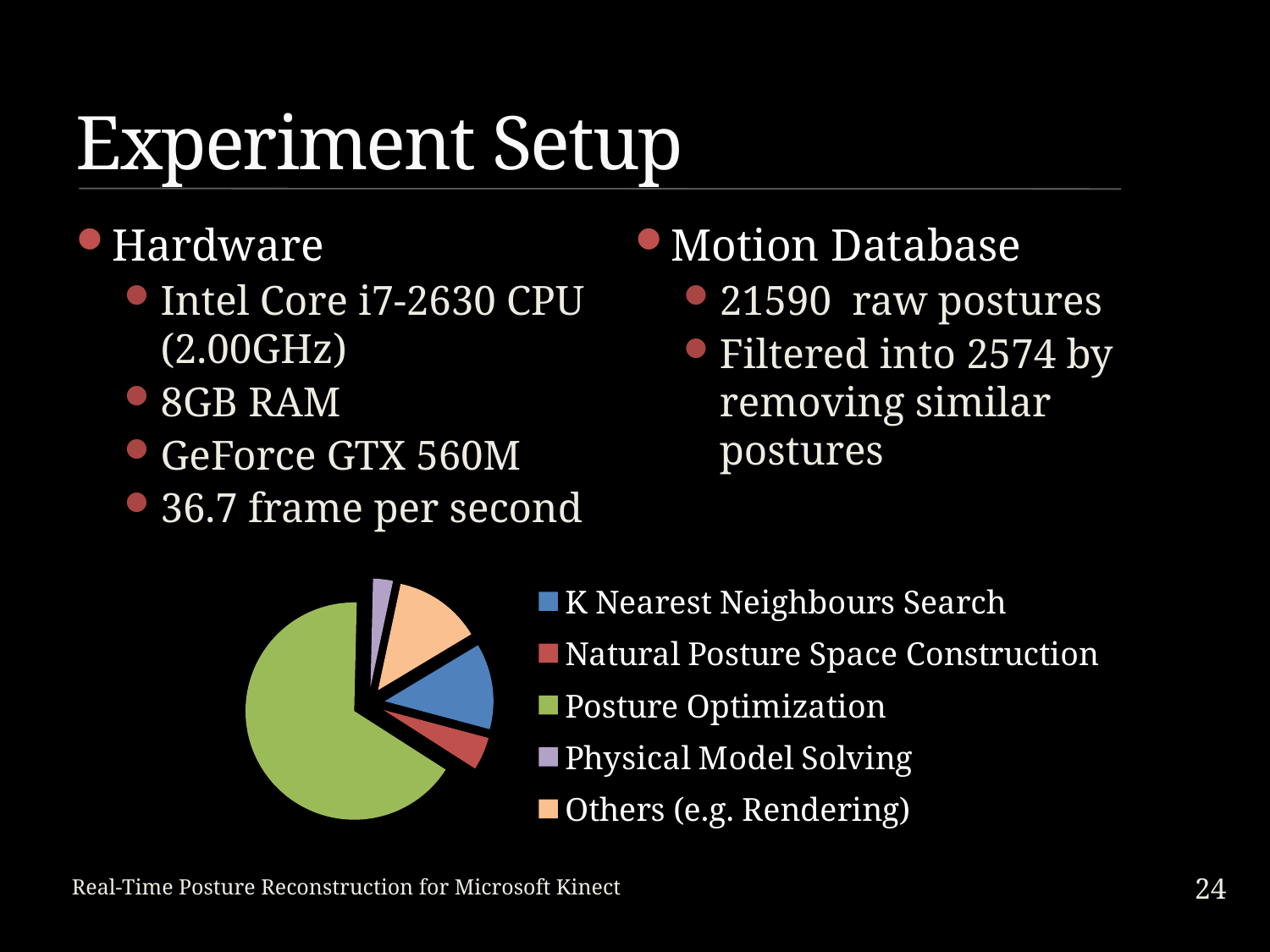
Does the Posture Optimization slice take up more or less than half of the pie chart? more Which category takes up the smallest share of the pie chart? Physical Model Solving Which slice is larger in the pie chart: Others (e.g. Rendering) or Physical Model Solving? Others (e.g. Rendering) Which slice is larger in the pie chart: K Nearest Neighbours Search or Natural Posture Space Construction? K Nearest Neighbours Search What kind of chart is shown on the slide? pie chart Which slice is larger in the pie chart: Natural Posture Space Construction or Physical Model Solving? Natural Posture Space Construction How many categories does the pie chart's legend list? 5 Which category takes up the largest share of the pie chart? Posture Optimization What colour is the Posture Optimization slice in the pie chart? green Which legend entry is shown in orange in the pie chart? Others (e.g. Rendering)